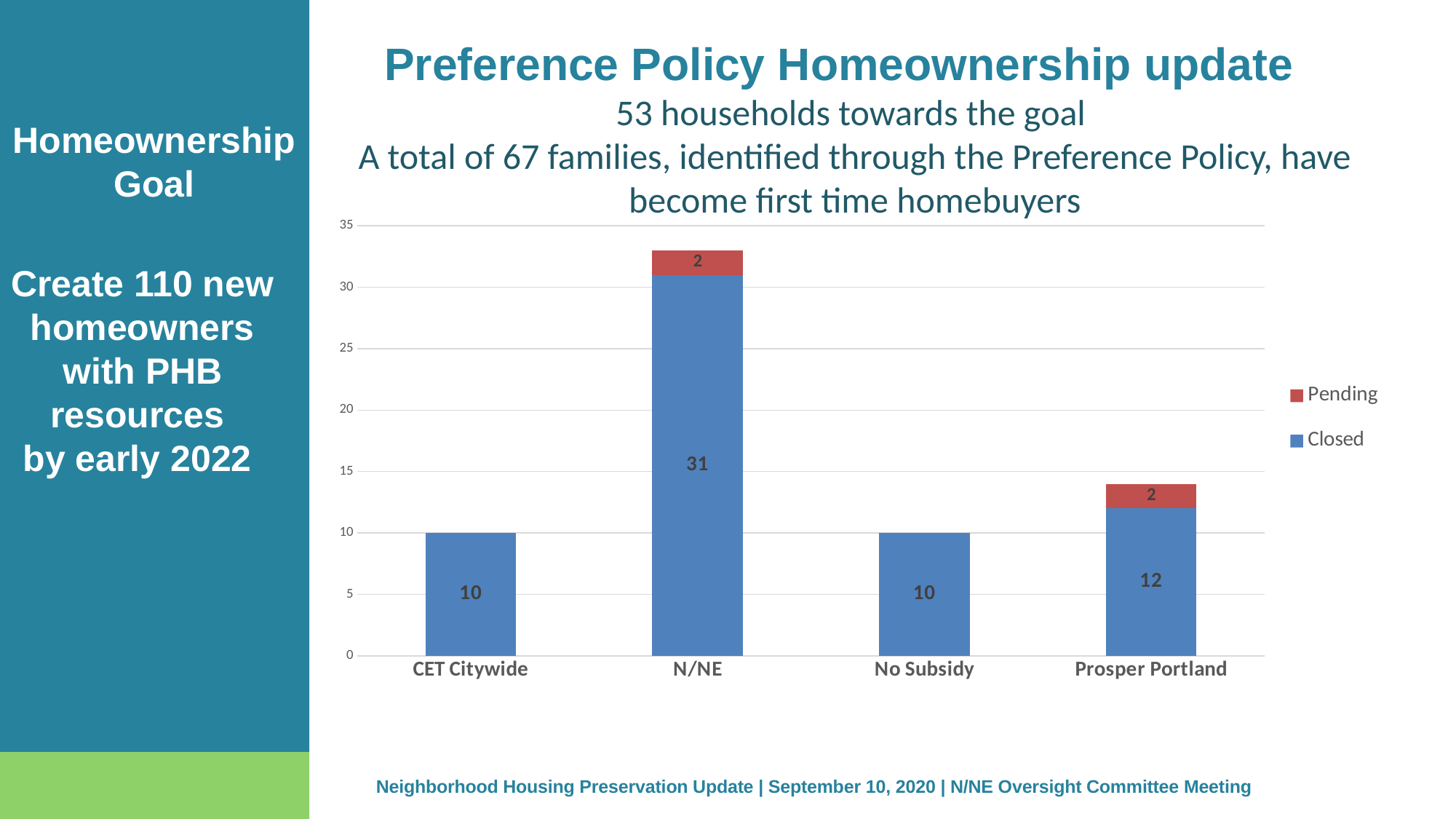
What is the Pending value for Prosper Portland? 2 How many series does the legend list? 2 What is the difference between the Closed values for N/NE and Prosper Portland? 19 What is the total of the stacked bar for Prosper Portland? 14 What is the Closed value for N/NE? 31 Which category has the highest Closed value? N/NE Which is larger, the Closed value for Prosper Portland or the Closed value for No Subsidy? Prosper Portland What kind of chart is shown on the slide? Stacked bar chart What is the Closed value for CET Citywide? 10 How many categories are shown on the x axis? 4 Which series is shown in red in the legend? Pending What is the total of the stacked bar for N/NE? 33